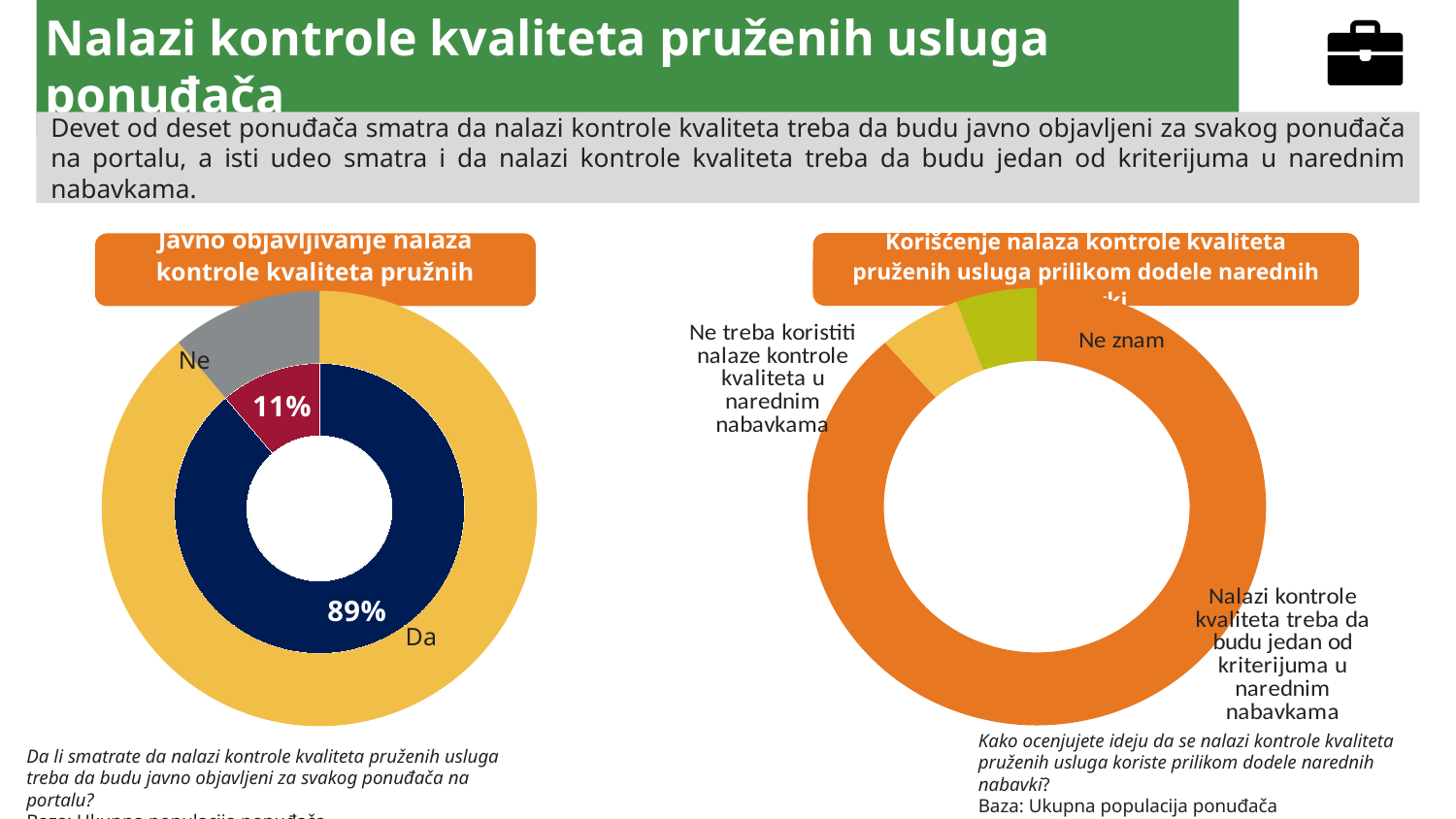
In the right chart (Korišćenje nalaza kontrole kvaliteta), which category has the largest share? Nalazi kontrole kvaliteta treba da budu jedan od kriterijuma u narednim nabavkama How many labelled categories does the left chart show? 2 What kind of chart is the left chart? Doughnut (pie) chart In the left chart, what is the difference in percentage points between "Da" and "Ne"? 78 percentage points In the left chart (Javno objavljivanje nalaza kontrole kvaliteta), what percentage is shown for "Ne"? 11% In the left chart, which is larger, "Da" or "Ne"? Da In the left chart (Javno objavljivanje nalaza kontrole kvaliteta), what percentage is shown for "Da"? 89% In the left chart, which category has the highest share? Da In the left chart, what colour is the "Da" segment of the inner ring? Dark blue How many categories does the right chart show? 3